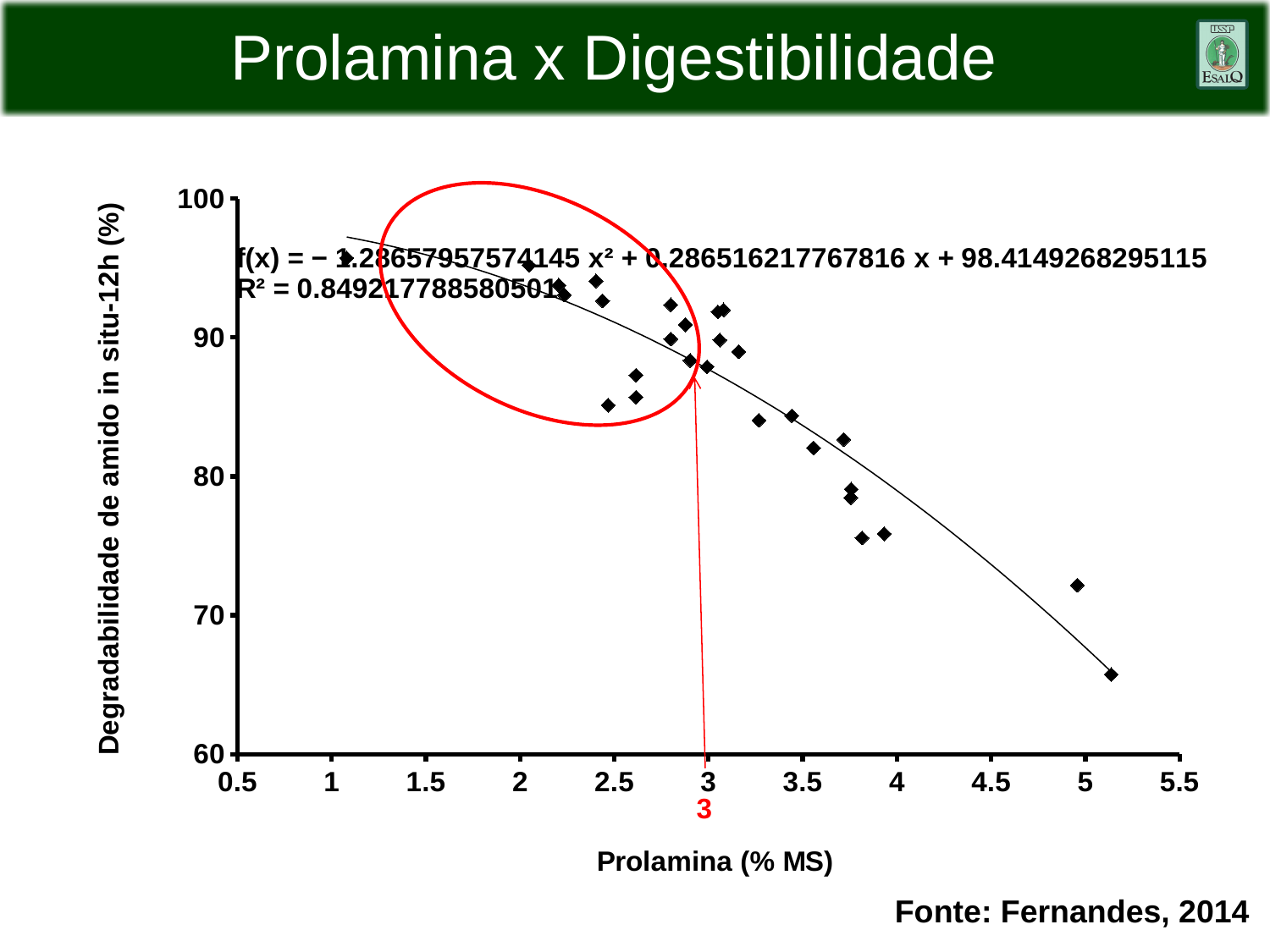
Is the R² value of the fitted curve greater or less than 0.8? greater What is the title of the chart on the slide? Prolamina x Digestibilidade Which point has the lower degradability: the one at Prolamina of about 5 or the one at about 5.15? The one at about 5.15 Is the degradability value for the point at the far right of the chart (Prolamina just above 5) greater or less than 70? less What kind of chart is shown on the slide? Scatter chart What Prolamina value is highlighted in red below the x axis? 3 What is the label of the x axis? Prolamina (% MS) What is the constant term in the fitted equation f(x) shown on the chart? 98.4149268295115 As Prolamina (% MS) increases along the x axis, do the degradability values generally rise or fall? Fall What is the highest value shown on the y axis? 100 Are the degradability values for the points at Prolamina of about 3.8 greater or less than 80? less